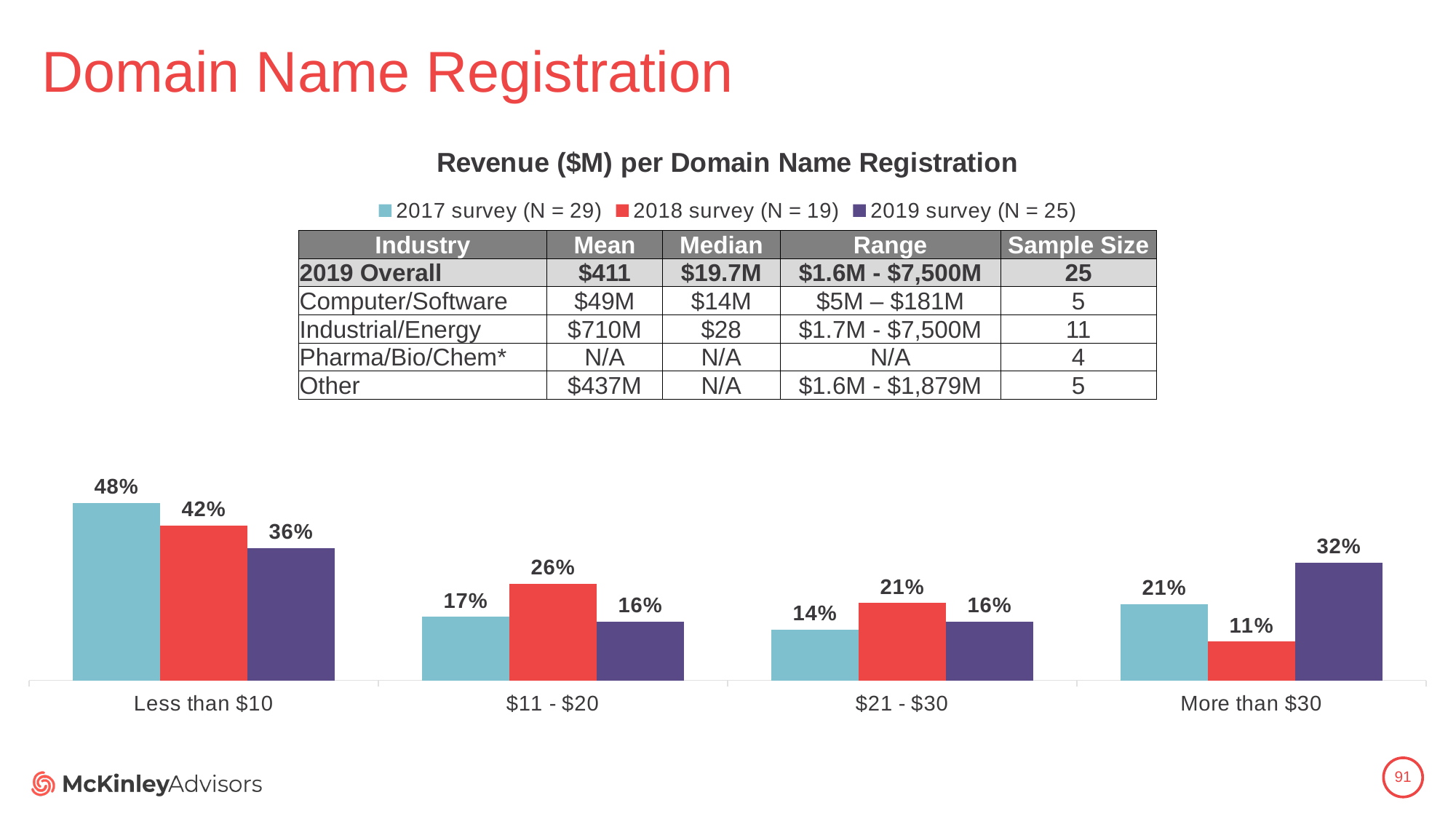
How many categories are shown on the x axis of the chart? 4 What is the title of the chart? Revenue ($M) per Domain Name Registration What is the sample size (N) for the 2018 survey according to the legend? 19 What is the value for the 2018 survey in the '$11 - $20' category? 26% Which category has the lowest value for the 2018 survey? More than $30 What kind of chart is shown on the slide? Bar chart How many series does the chart legend list? 3 What is the value for the 2019 survey in the 'More than $30' category? 32% What is the value for the 2017 survey in the 'Less than $10' category? 48% In the 'More than $30' category, which is larger: the 2017 survey value or the 2018 survey value? 2017 survey Which category has the highest value for the 2019 survey? Less than $10 What is the difference between the 2017 survey and 2019 survey values in the 'Less than $10' category? 12%